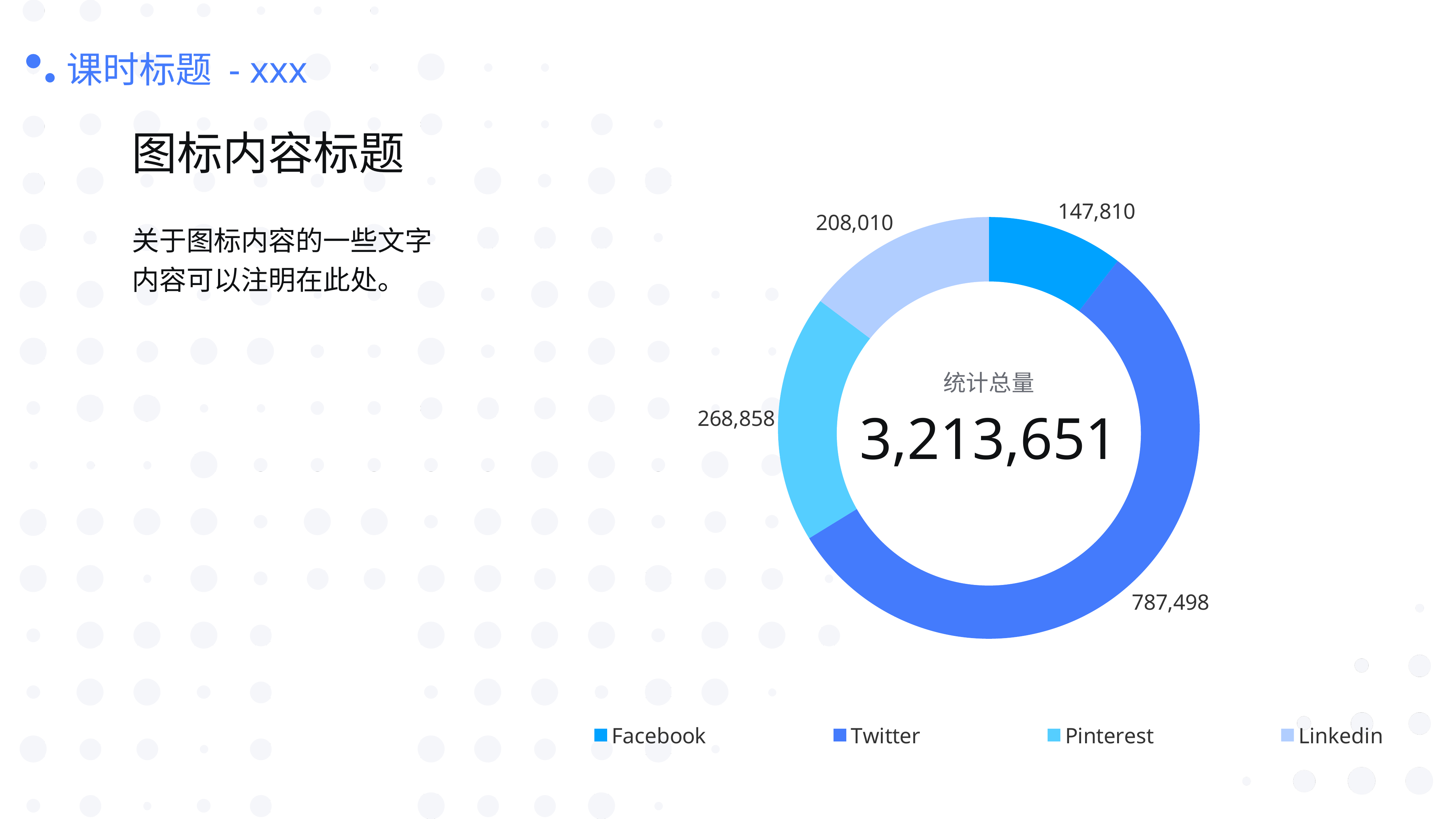
Which is larger, the value for Pinterest or the value for Linkedin? Pinterest What number is printed in the centre of the doughnut chart? 3,213,651 What is the value for Linkedin? 208,010 Which category has the largest slice? Twitter How many categories does the chart show? 4 What is the value for Twitter? 787,498 What is the difference between the values for Linkedin and Facebook? 60,200 Which category has the smallest slice? Facebook What kind of chart is shown on the slide? doughnut chart What is the difference between the values for Twitter and Pinterest? 518,640 What is the value for Facebook? 147,810 What is the value for Pinterest? 268,858